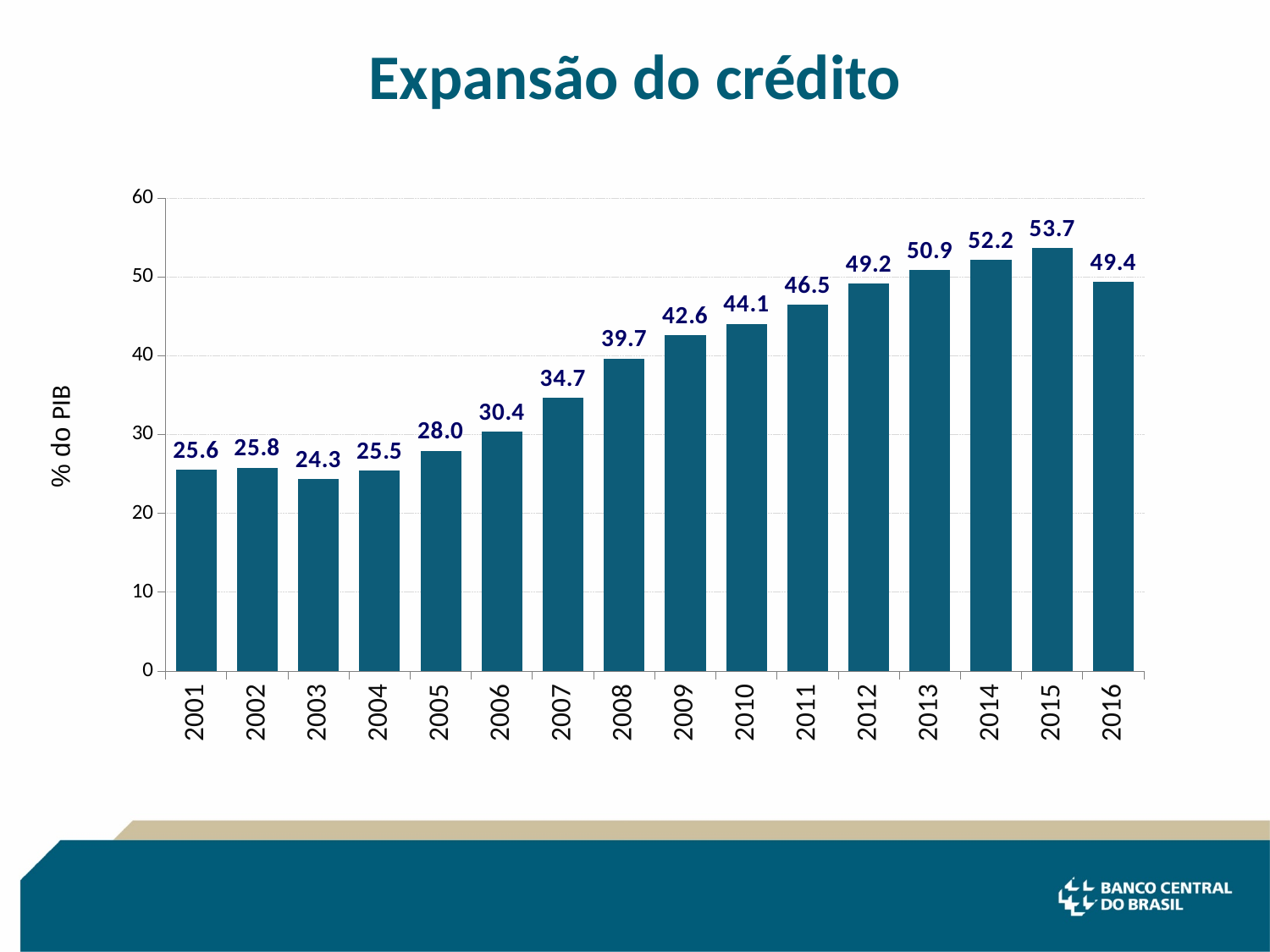
What is the value for 2016? 49.4 How many years are shown on the x axis? 16 What is the label of the y axis? % do PIB What kind of chart is shown? bar chart What is the value for 2008? 39.7 Which is larger, the value for 2012 or the value for 2016? 2016 Which year has the highest value? 2015 What is the difference between the values for 2015 and 2016? 4.3 What is the difference between the values for 2008 and 2007? 5.0 Is the value for 2011 greater or less than 40? greater Which year has the lowest value? 2003 What is the value for 2003? 24.3